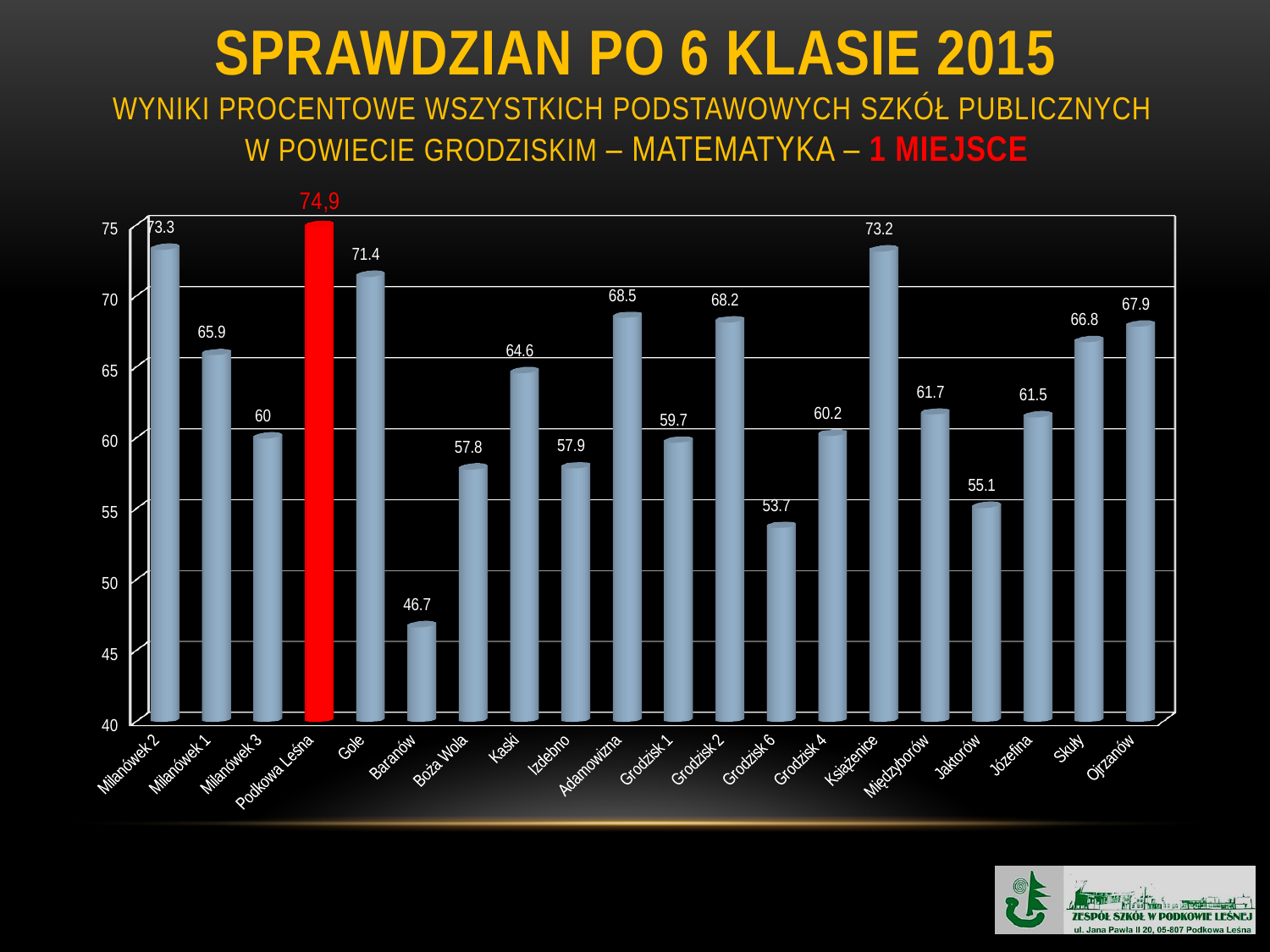
What is the difference between the values for Gole and Baranów? 24.7 What is the value for Podkowa Leśna? 74,9 What is the value for Baranów? 46.7 Which school has the lowest value? Baranów How many schools are shown on the chart? 20 Which is larger, the value for Kaski or the value for Skuły? Skuły What is the difference between the values for Podkowa Leśna and Milanówek 2? 1.6 Which school has the highest value? Podkowa Leśna What kind of chart is shown on the slide? bar chart What is the value for Grodzisk 6? 53.7 Is the value for Grodzisk 6 greater or less than 55? less What is the value for Książenice? 73.2